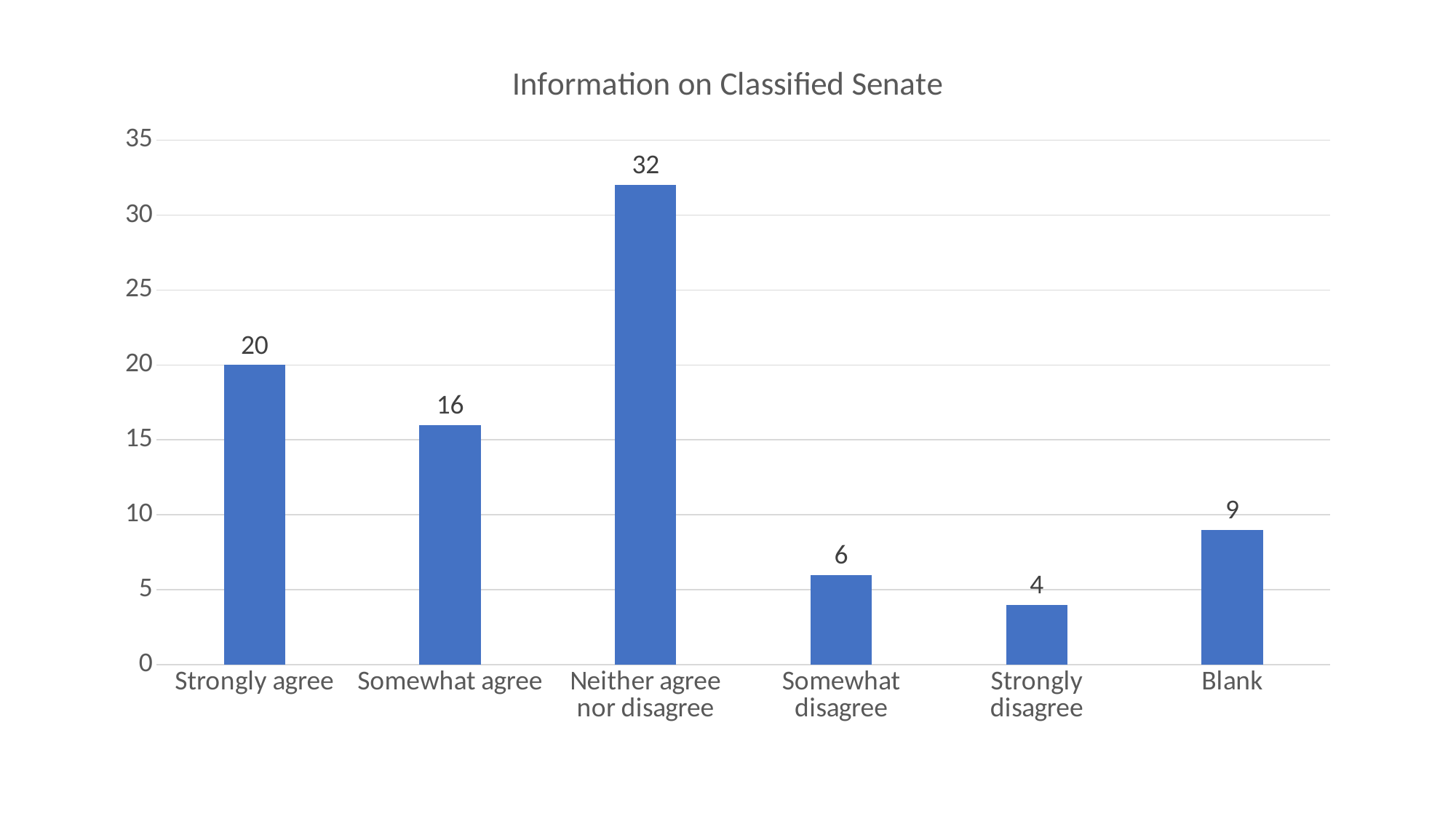
What is the difference between the values for Strongly agree and Somewhat agree? 4 What kind of chart is this? bar chart Which category has the highest value? Neither agree nor disagree Which category has the lowest value? Strongly disagree What is the value for Strongly agree? 20 What is the difference between the values for Neither agree nor disagree and Blank? 23 How many categories are shown on the x axis? 6 What is the value for Blank? 9 What is the value for Neither agree nor disagree? 32 What is the title of the chart? Information on Classified Senate Which is larger, the value for Somewhat disagree or the value for Blank? Blank Is the value for Somewhat agree greater or less than 15? greater